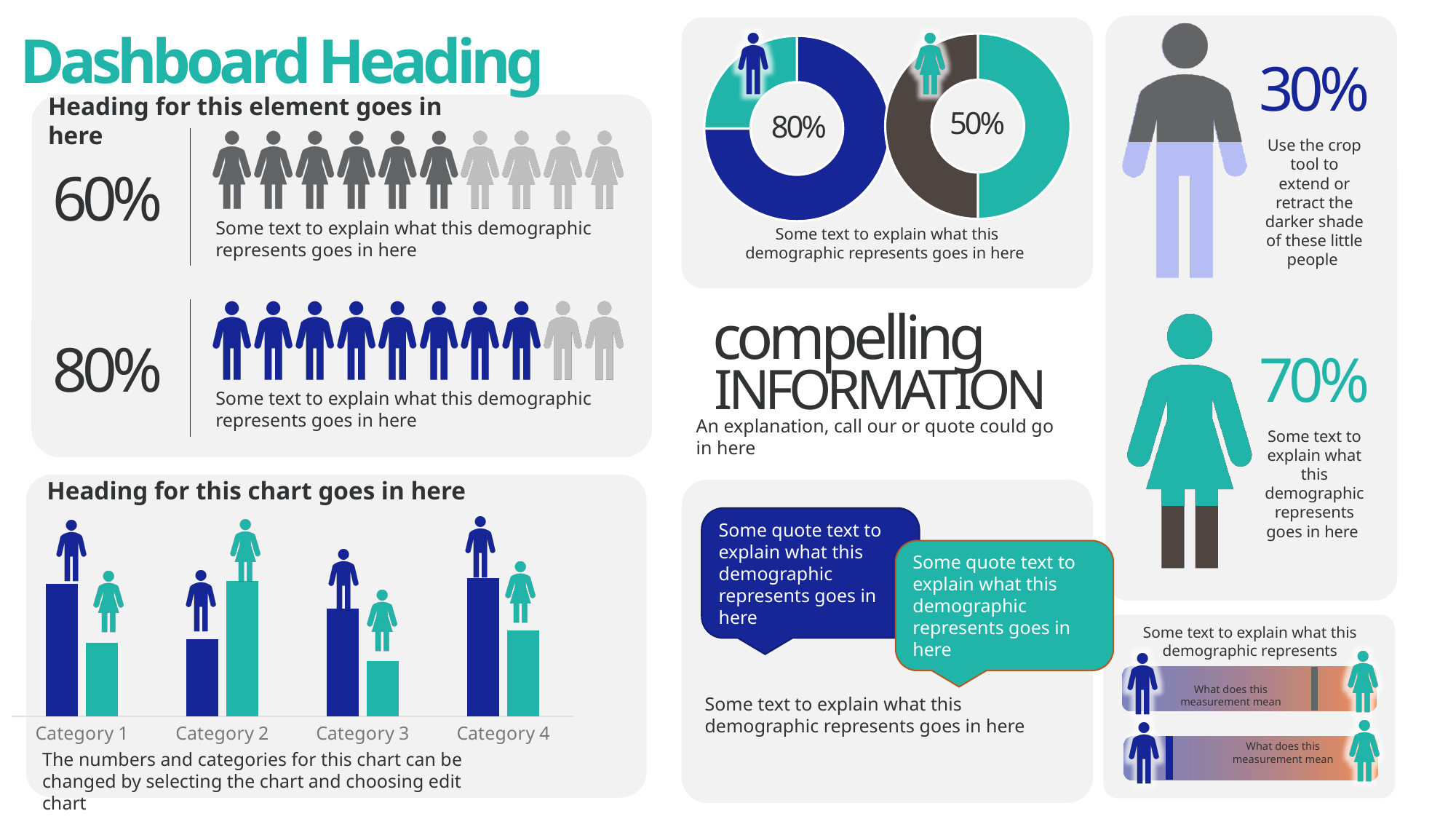
What percentage is shown in the centre of the left (blue) donut chart at the top of the slide? 80% In the chart titled 'Heading for this chart goes in here', which category has the tallest blue bar? Category 4 What percentage is shown in the centre of the right (teal and brown) donut chart at the top of the slide? 50% How many person icons are in the top row of the pictogram labelled 60% in the element 'Heading for this element goes in here'? 10 In the chart titled 'Heading for this chart goes in here', which category has the shortest teal bar? Category 3 In the chart titled 'Heading for this chart goes in here', is the blue bar or the teal bar taller for Category 2? teal What is the difference between the percentages shown in the left donut chart and the right donut chart at the top of the slide? 30% In the chart titled 'Heading for this chart goes in here', is the blue bar or the teal bar taller for Category 1? blue How many categories does the chart titled 'Heading for this chart goes in here' show? 4 In the chart titled 'Heading for this chart goes in here', which category has the tallest teal bar? Category 2 In the chart titled 'Heading for this chart goes in here', is the blue bar or the teal bar taller for Category 4? blue What kind of chart is the chart titled 'Heading for this chart goes in here'? bar chart